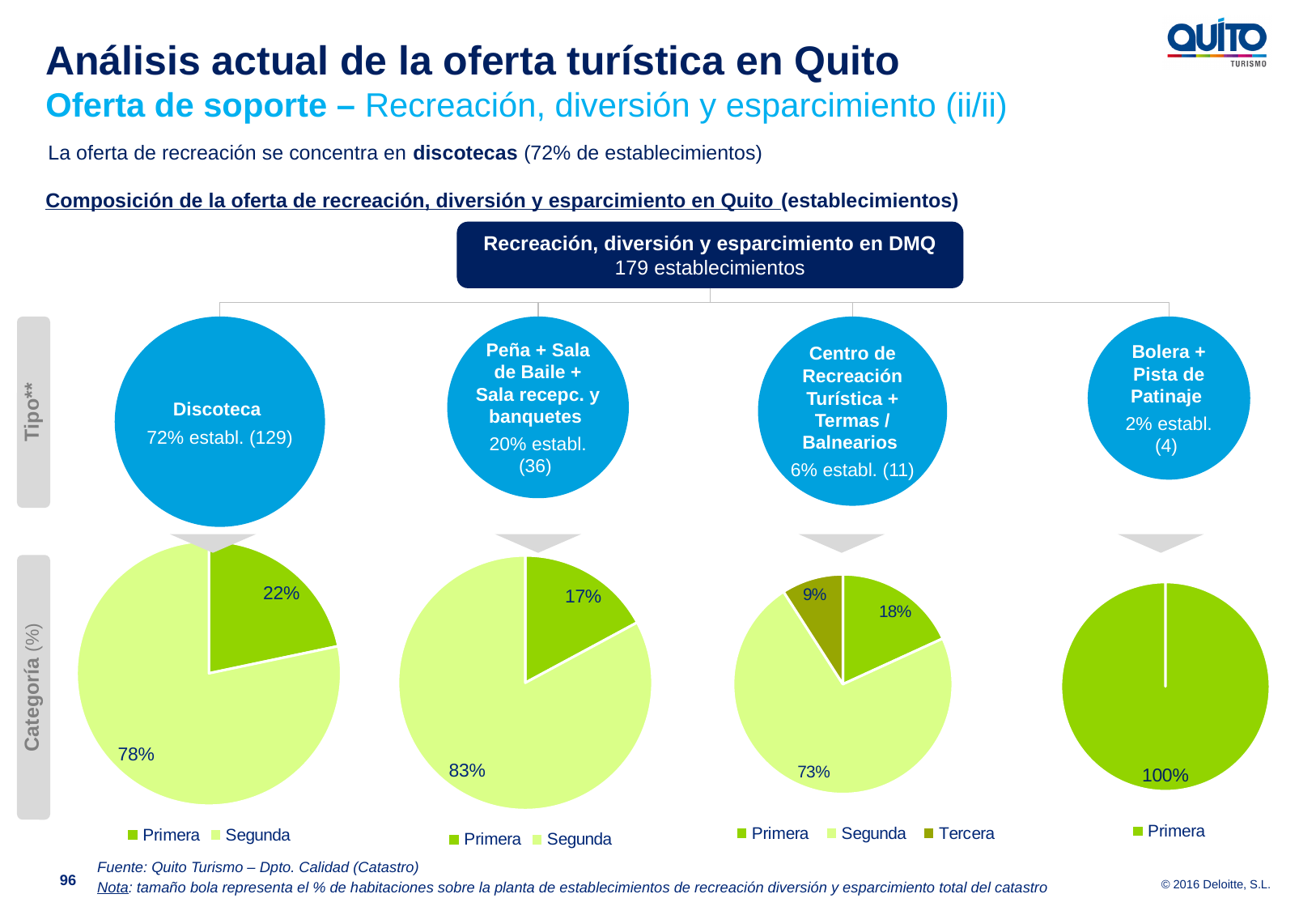
How many categories does the legend of the pie chart under Centro de Recreación Turística + Termas / Balnearios list? 3 In the pie chart under Centro de Recreación Turística + Termas / Balnearios, which category has the smallest share? Tercera In the pie chart under Peña + Sala de Baile + Sala recepc. y banquetes, what share is Primera? 17% Is the Primera share larger in the pie chart under Discoteca or in the pie chart under Peña + Sala de Baile + Sala recepc. y banquetes? Discoteca In the pie chart under Discoteca, what share is Segunda? 78% In the pie chart under Centro de Recreación Turística + Termas / Balnearios, what share is Tercera? 9% In the pie chart under Bolera + Pista de Patinaje, what share is Primera? 100% What kind of charts are shown in the bottom row of the slide? Pie charts In the pie chart under Discoteca, what is the difference between the Segunda and Primera shares? 56% In the pie chart under Centro de Recreación Turística + Termas / Balnearios, which category has the largest share? Segunda In the pie chart under Discoteca, what share is Primera? 22% How many categories does the legend of the pie chart under Bolera + Pista de Patinaje list? 1